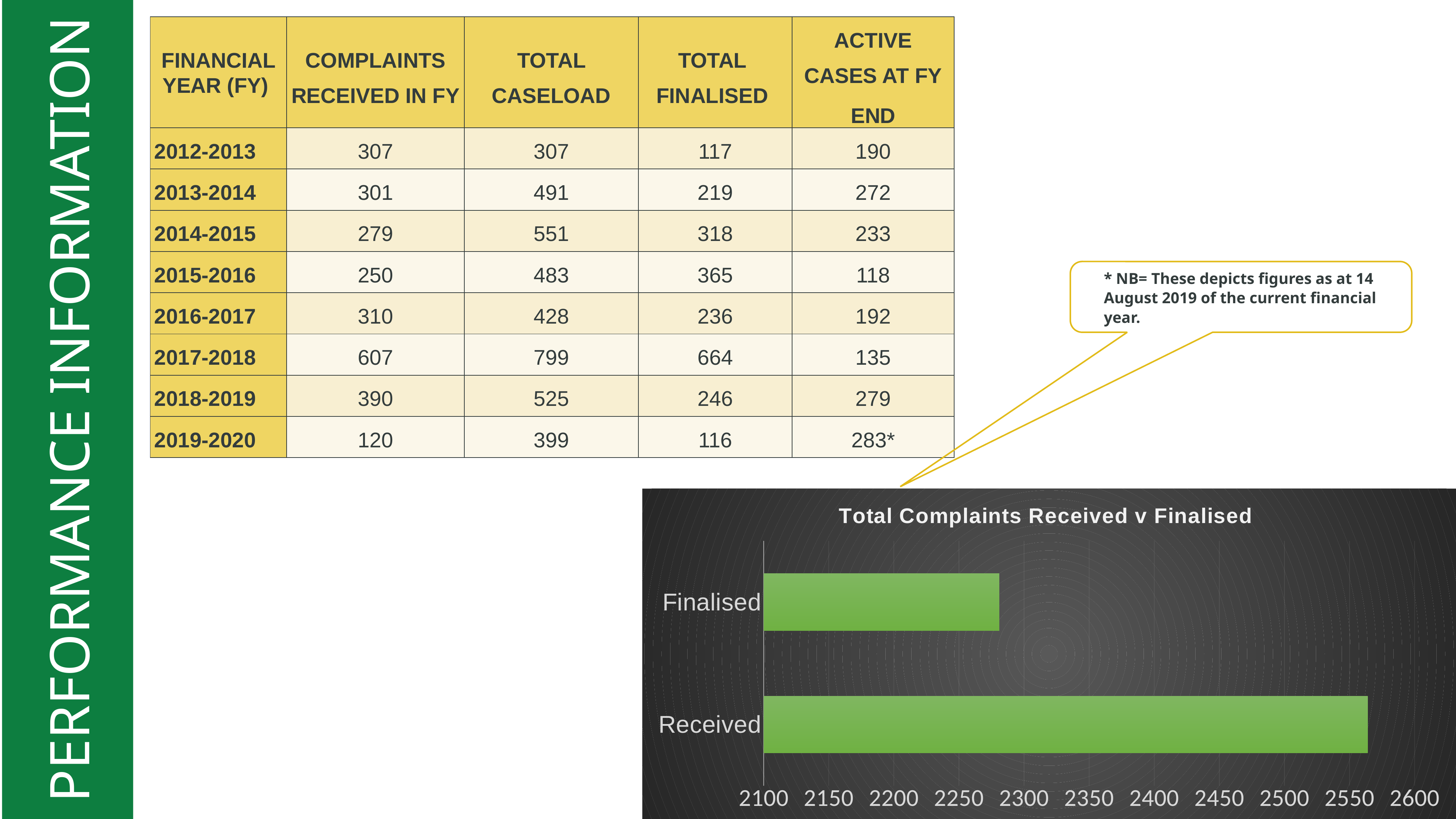
Is the value for Received greater or less than 2500? greater What kind of chart is shown on the slide? bar chart Is the value for Finalised greater or less than 2300? less Is the value for Finalised greater or less than 2250? greater What is the title of the chart on the slide? Total Complaints Received v Finalised How many categories does the chart show? 2 Which category has the highest value in the chart? Received Which is larger in the chart, Received or Finalised? Received Which category has the lowest value in the chart? Finalised What colour are the bars in the chart? green